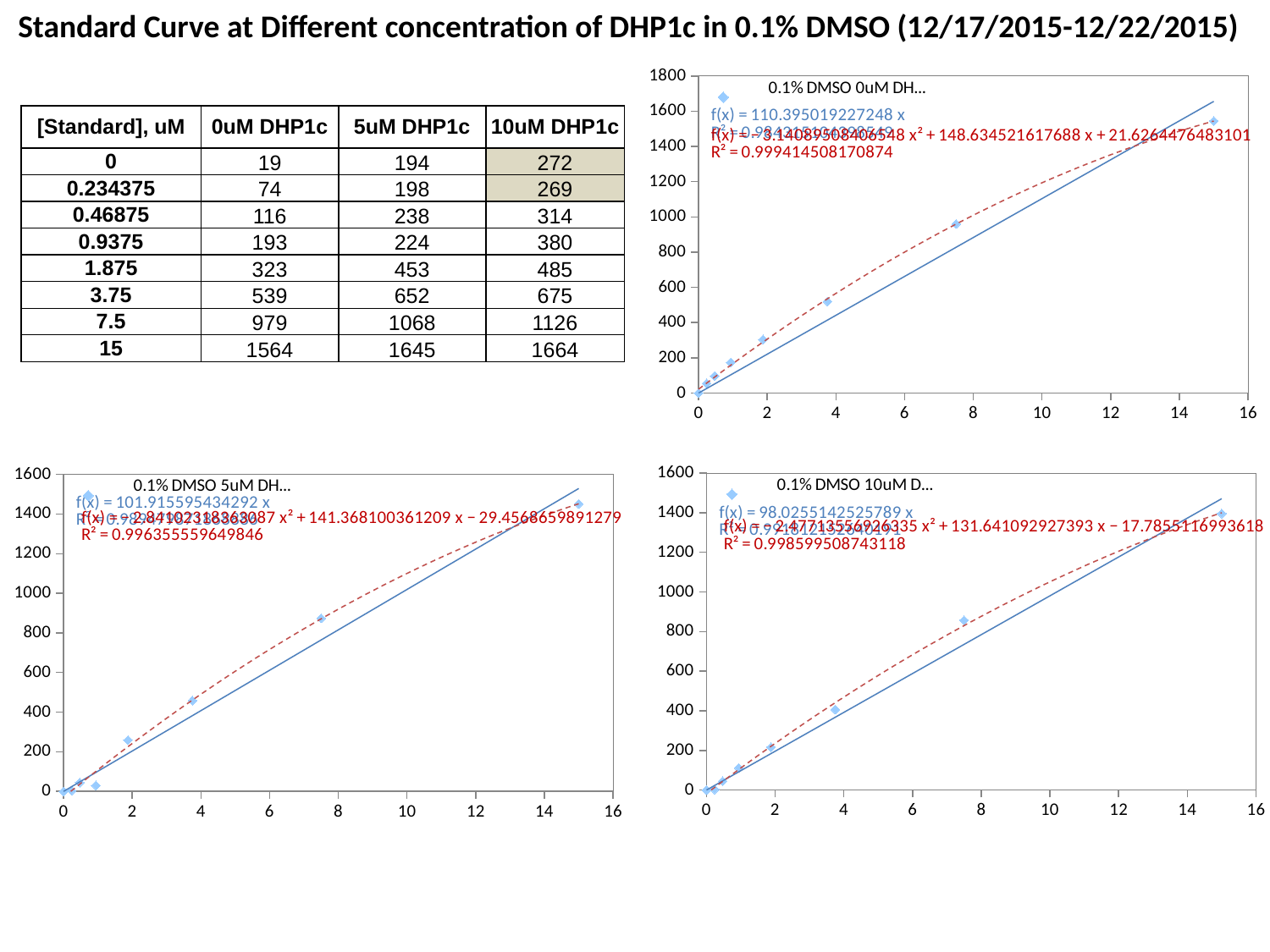
In the top-right chart (0.1% DMSO 0uM DH...), is the value of the point at x = 7.5 greater or less than 800? greater What kind of chart is the top-right chart titled "0.1% DMSO 0uM DH..."? Scatter chart In the bottom-left chart (0.1% DMSO 5uM DH...), is the value of the point at x = 7.5 greater or less than 1000? less In the bottom-right chart (0.1% DMSO 10uM D...), is the value of the point at x = 7.5 greater or less than 800? greater What R² value is printed in red for the polynomial fit on the top-right chart (0.1% DMSO 0uM DH...)? 0.999414508170874 In the bottom-right chart (0.1% DMSO 10uM D...), do the plotted values rise or fall along the x axis? Rise How many data points are plotted in the bottom-left chart (0.1% DMSO 5uM DH...)? 8 What R² value is printed in red for the polynomial fit on the bottom-right chart (0.1% DMSO 10uM D...)? 0.998599508743118 In the top-right chart (0.1% DMSO 0uM DH...), do the plotted values rise or fall as the x value increases? Rise